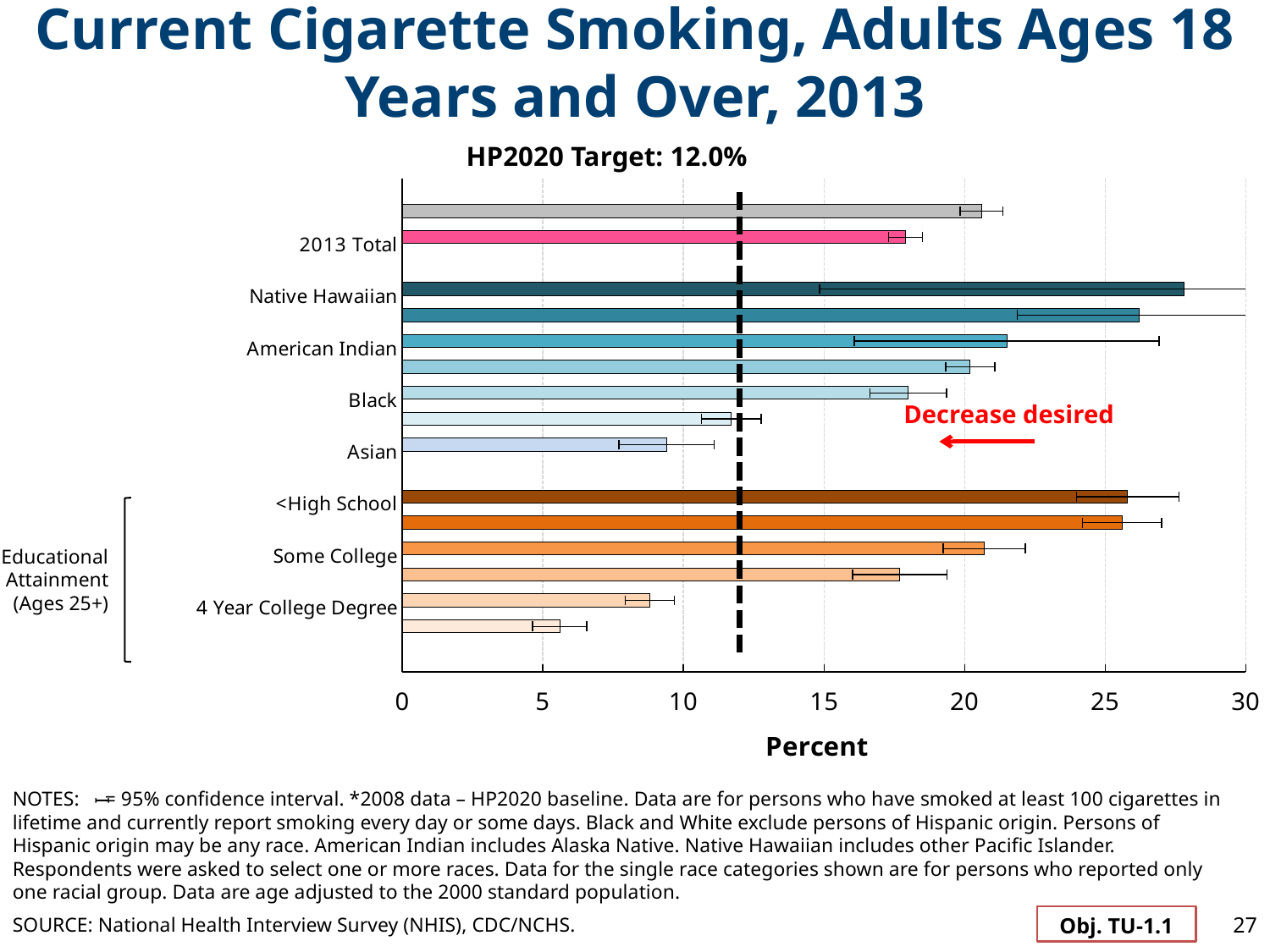
Is the value for Asian greater or less than 10? less What is the HP2020 Target value shown above the chart? 12.0% Which is larger, the value for Native Hawaiian or the value for Black? Native Hawaiian Is the value for Black greater or less than 15? greater Is the value for 4 Year College Degree greater or less than 10? less What is the label of the horizontal axis? Percent Which is larger, the value for Some College or the value for Asian? Some College What kind of chart is shown on the slide? bar chart Among the labeled groups, which has the highest smoking percentage? Native Hawaiian